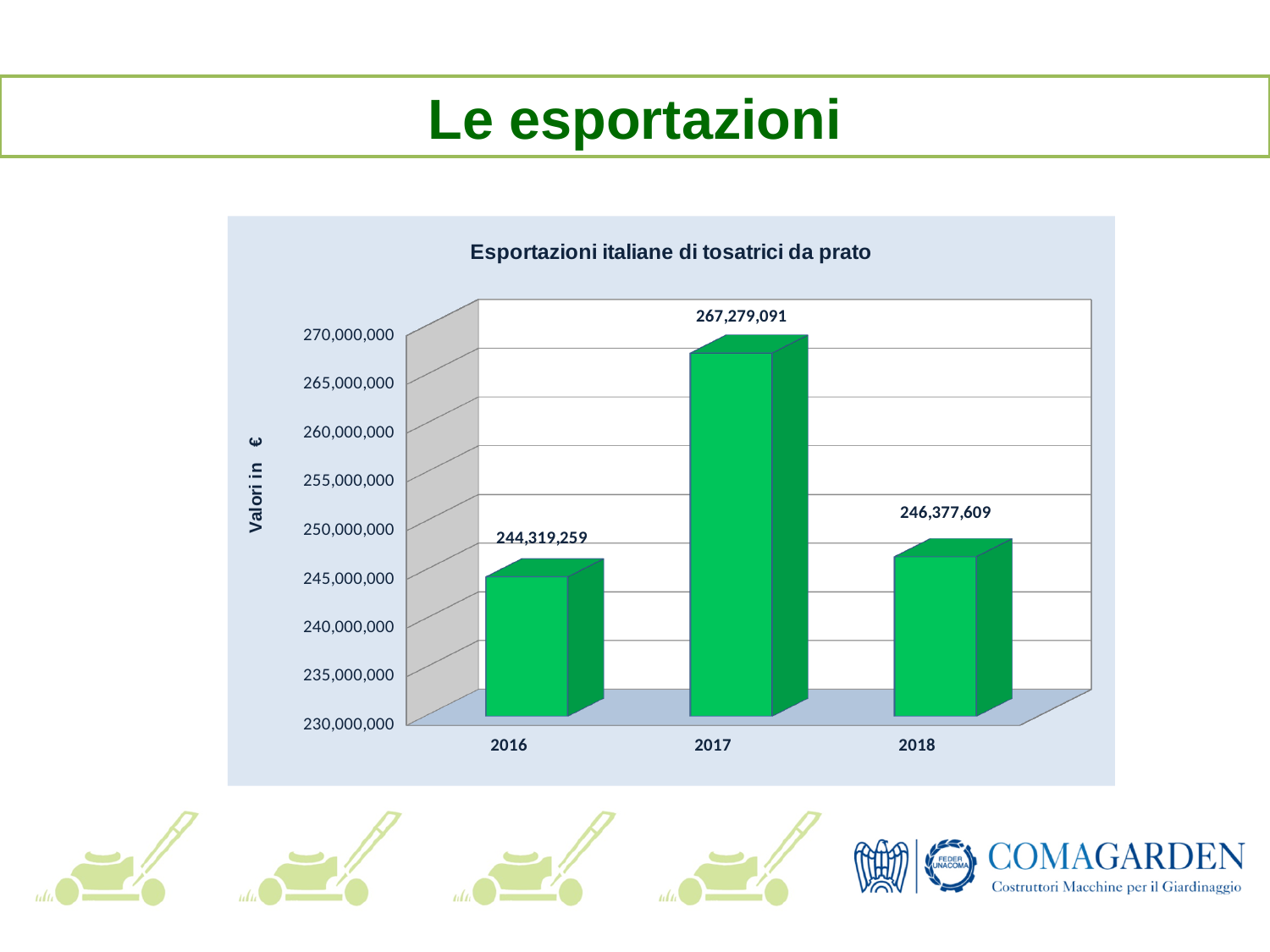
What is the title of the chart? Esportazioni italiane di tosatrici da prato What is the difference between the values for 2017 and 2016? 22,959,832 What is the value for 2016? 244,319,259 How many years are shown on the x axis? 3 What is the value for 2018? 246,377,609 Which is larger, the value for 2018 or the value for 2016? 2018 Is the value for 2017 greater or less than 265,000,000? greater Which year has the highest value? 2017 What is the difference between the values for 2017 and 2018? 20,901,482 What is the value for 2017? 267,279,091 Which year has the lowest value? 2016 What kind of chart is shown? bar chart